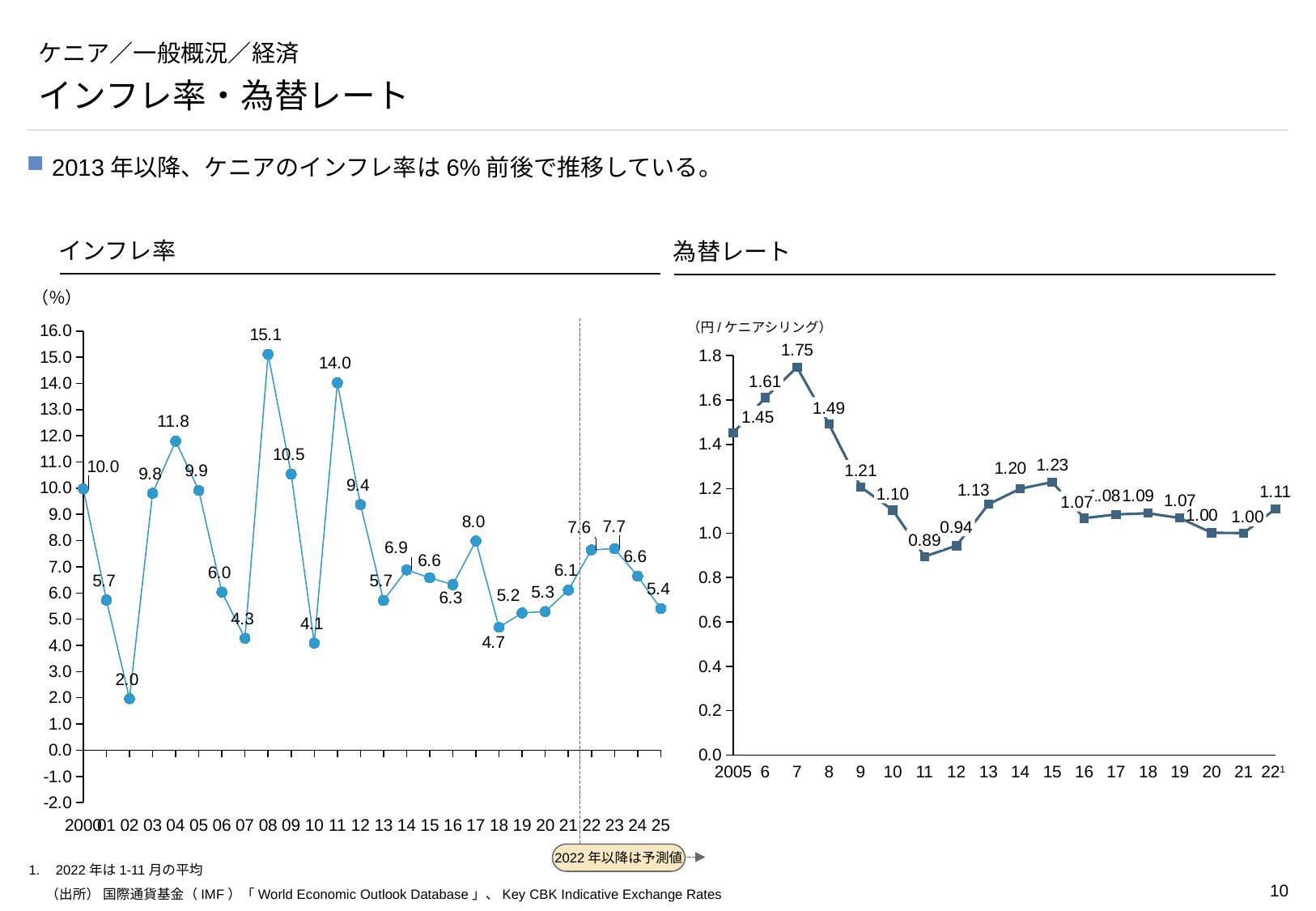
In the インフレ率 chart, is the value for 2017 larger than the value for 2018? Yes, 2017 (8.0) In the 為替レート chart, what is the difference between the 2007 value and the 2011 value? 0.86 In the インフレ率 chart, which year has the lowest inflation rate? 2002 In the インフレ率 chart, what is the inflation rate for 2025? 5.4 In the 為替レート chart, which year has the lowest exchange rate? 2011 In the インフレ率 chart, what is the inflation rate for 2008? 15.1 What type of chart is the 為替レート chart? Line chart In the インフレ率 chart, which year has the highest inflation rate? 2008 In the 為替レート chart, what is the exchange rate for 2007? 1.75 In the 為替レート chart, what unit is shown on the axis label? 円/ケニアシリング In the 為替レート chart, how many years are plotted? 18 In the インフレ率 chart, what is the difference between the 2011 value and the 2010 value? 9.9